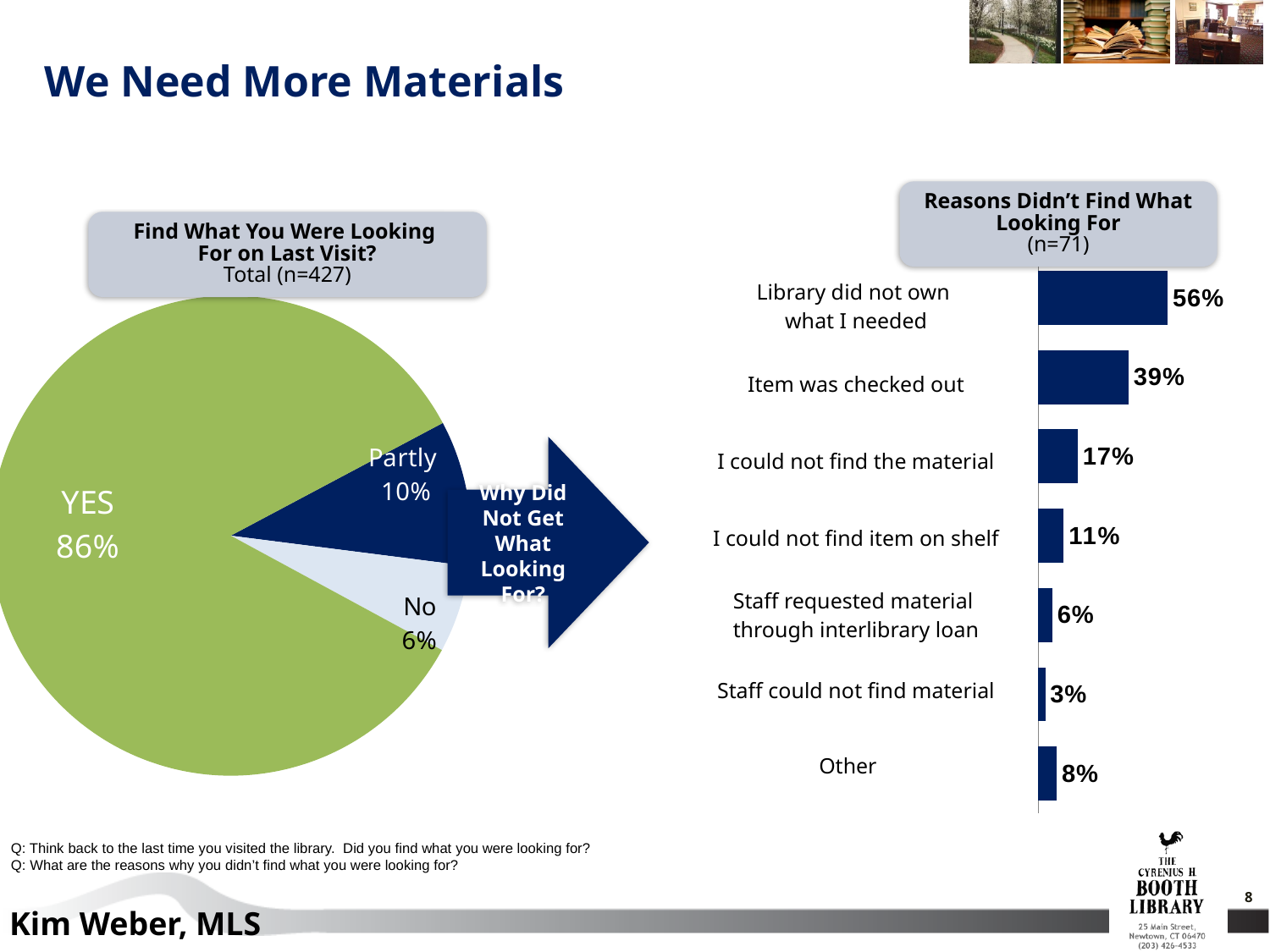
In the 'Reasons Didn't Find What Looking For' chart, which reason has the highest value? Library did not own what I needed In the 'Reasons Didn't Find What Looking For' chart, what is the value for 'Item was checked out'? 39% In the 'Reasons Didn't Find What Looking For' chart, which reason has the lowest value? Staff could not find material In the 'Reasons Didn't Find What Looking For' chart, what is the difference between 'Library did not own what I needed' and 'Item was checked out'? 17% In the 'Find What You Were Looking For on Last Visit?' pie chart, how many slices are there? 3 What kind of chart is the 'Reasons Didn't Find What Looking For' chart? Bar chart What kind of chart is the 'Find What You Were Looking For on Last Visit?' chart? Pie chart In the 'Find What You Were Looking For on Last Visit?' pie chart, which response has the smallest slice? No In the 'Find What You Were Looking For on Last Visit?' pie chart, what share of respondents answered Partly? 10% In the 'Find What You Were Looking For on Last Visit?' pie chart, what share of respondents answered YES? 86% In the 'Reasons Didn't Find What Looking For' chart, which is larger: 'I could not find the material' or 'Other'? I could not find the material How many reasons are listed in the 'Reasons Didn't Find What Looking For' chart? 7